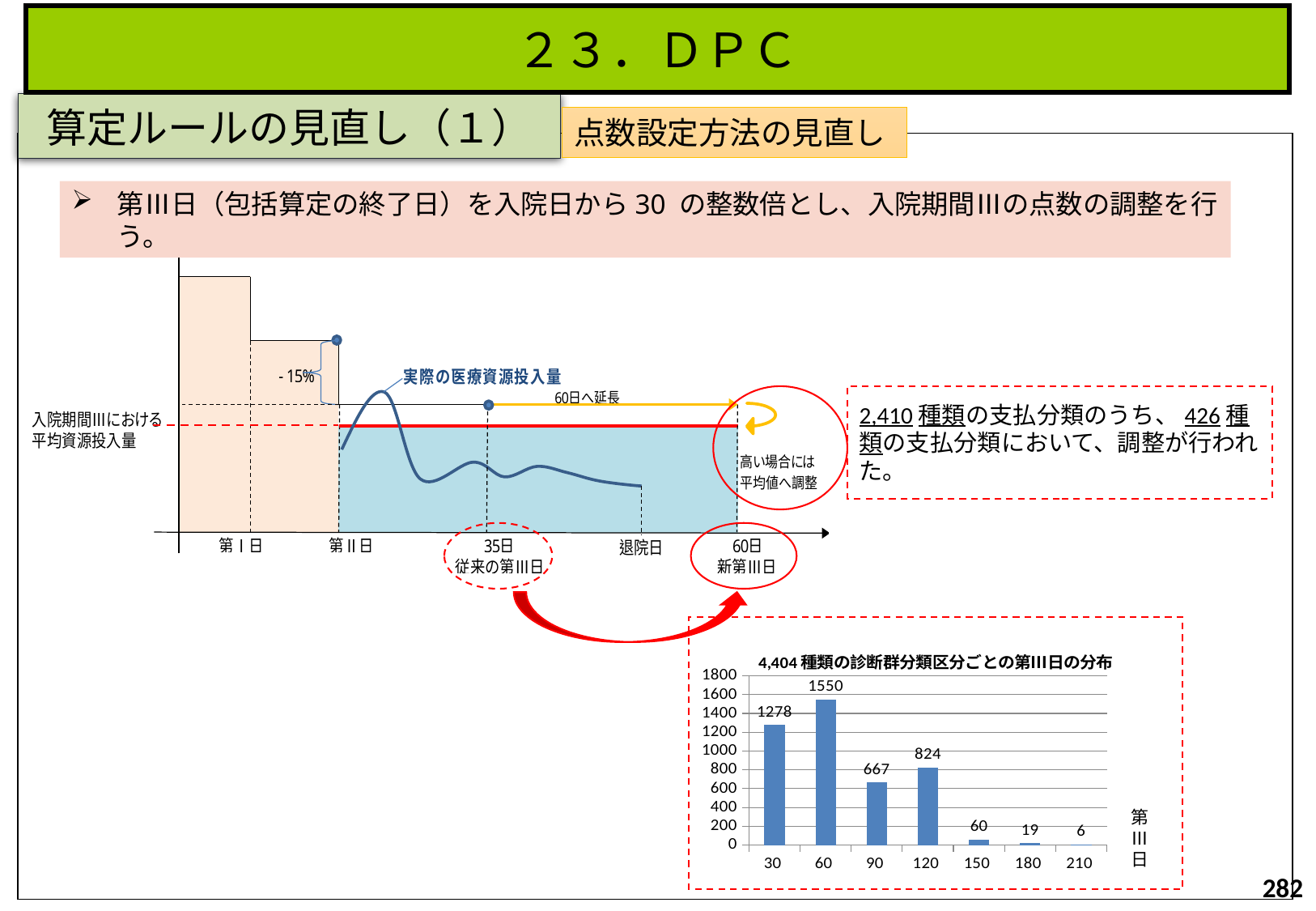
In the bar chart titled 4,404 種類の診断群分類区分ごとの第III日の分布, which is larger, the value for 90 or the value for 120? 120 In the bar chart titled 4,404 種類の診断群分類区分ごとの第III日の分布, what is the difference between the values for 60 and 30? 272 In the bar chart titled 4,404 種類の診断群分類区分ごとの第III日の分布, what is the value for 180? 19 In the bar chart titled 4,404 種類の診断群分類区分ごとの第III日の分布, what is the value for 30? 1278 In the bar chart titled 4,404 種類の診断群分類区分ごとの第III日の分布, what is the difference between the values for 120 and 90? 157 In the bar chart titled 4,404 種類の診断群分類区分ごとの第III日の分布, which category has the lowest value? 210 In the bar chart titled 4,404 種類の診断群分類区分ごとの第III日の分布, how many categories are shown on the x axis? 7 In the bar chart titled 4,404 種類の診断群分類区分ごとの第III日の分布, what is the highest tick value shown on the vertical axis? 1800 What kind of chart is the chart titled 4,404 種類の診断群分類区分ごとの第III日の分布? bar chart In the bar chart titled 4,404 種類の診断群分類区分ごとの第III日の分布, what is the value for 120? 824 In the bar chart titled 4,404 種類の診断群分類区分ごとの第III日の分布, which category has the highest value? 60 In the bar chart titled 4,404 種類の診断群分類区分ごとの第III日の分布, is the value for 150 greater or less than 200? less